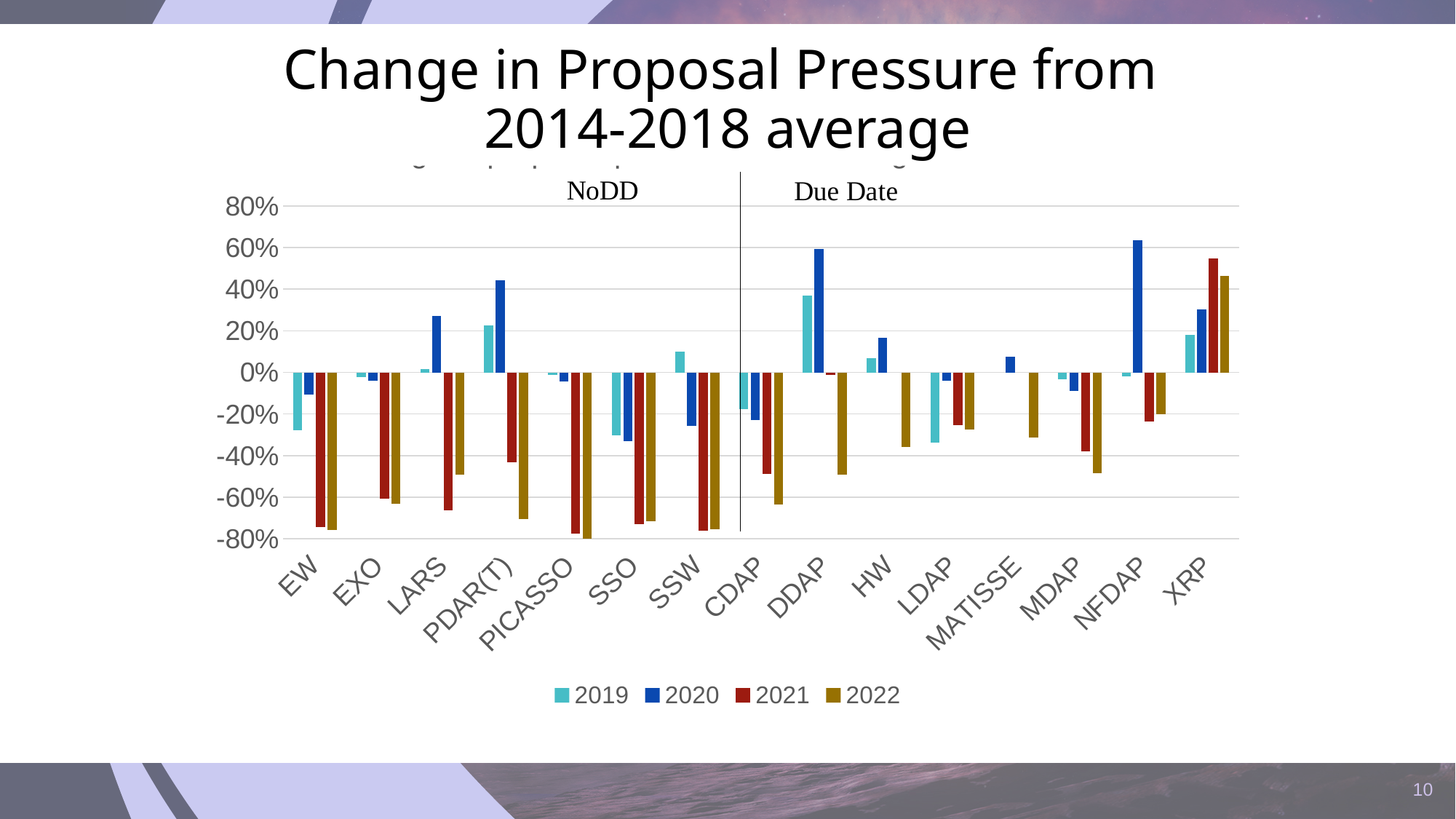
How many categories are shown on the x axis? 15 Is the 2022 value for PICASSO greater or less than -60%? less Which category has the highest 2020 value? NFDAP How many series does the legend list? 4 What kind of chart is shown on the slide? bar chart Is the 2021 value for EW greater or less than -60%? less Is the 2020 value for NFDAP greater or less than 60%? greater For XRP, which is larger: the 2021 value or the 2022 value? 2021 Which two group labels divide the chart into left and right sections? NoDD and Due Date For DDAP, which is larger: the 2019 value or the 2020 value? 2020